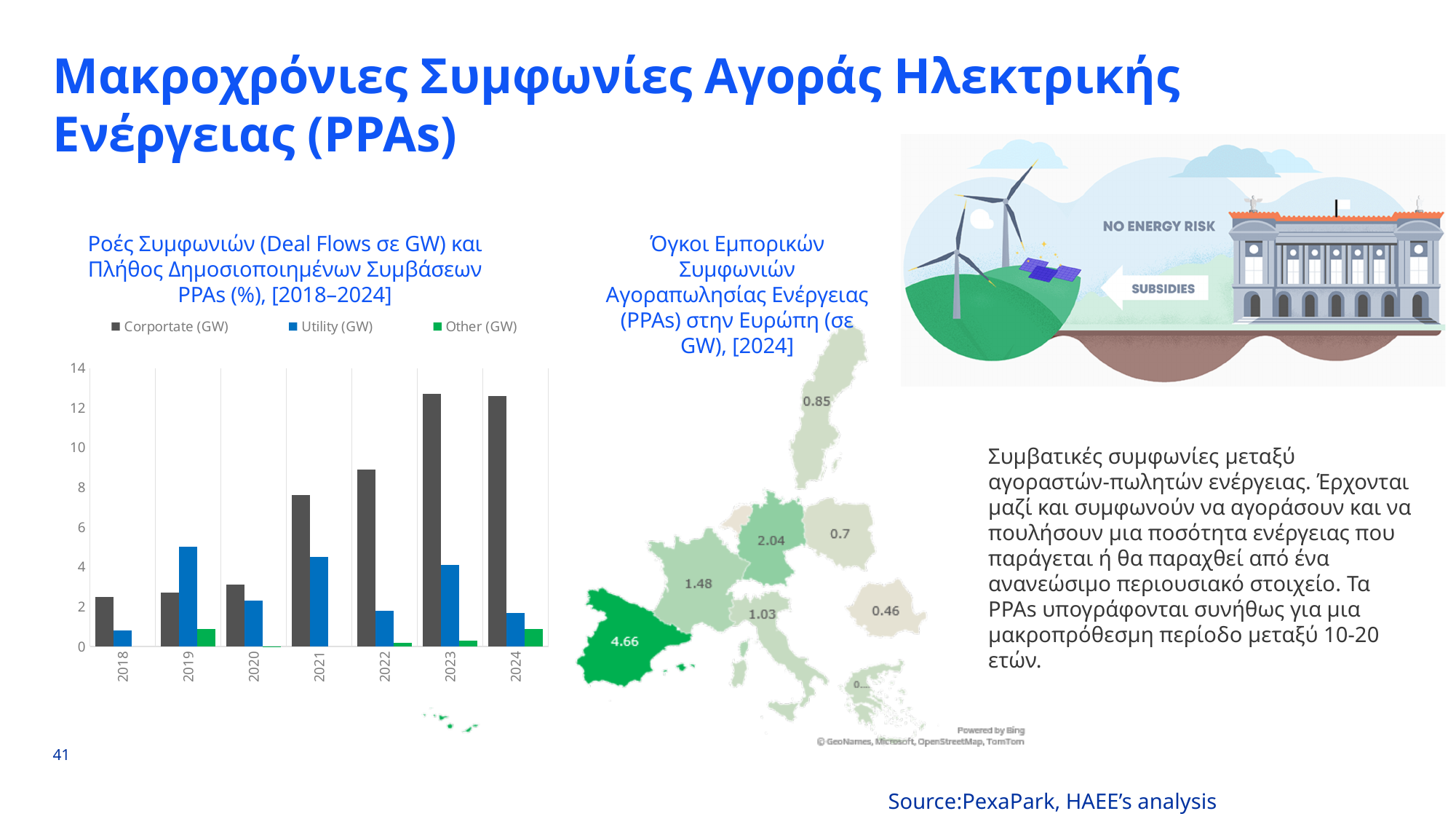
In the left bar chart, does the Corporate (GW) series generally rise or fall from 2018 to 2023? rise In the left bar chart, which is larger in 2019: Corporate (GW) or Utility (GW)? Utility (GW) What kind of chart is the left chart titled 'Ροές Συμφωνιών (Deal Flows σε GW)...'? bar chart In the left bar chart, which year has the lowest Utility (GW) value? 2018 In the map chart of PPA volumes in Europe (2024), what value is shown for Germany? 2.04 In the left bar chart, which year has the highest Utility (GW) value? 2019 In the left bar chart, is the Corporate (GW) value for 2018 greater or less than 4? less How many years are shown on the x axis of the left bar chart? 7 How many series does the legend of the left bar chart list? 3 In the map chart of PPA volumes in Europe (2024), what is the difference between the values for Spain and Germany? 2.62 In the left bar chart, is the Corporate (GW) value for 2023 greater or less than 12? greater In the map chart of PPA volumes in Europe (2024), what value is shown for Spain? 4.66